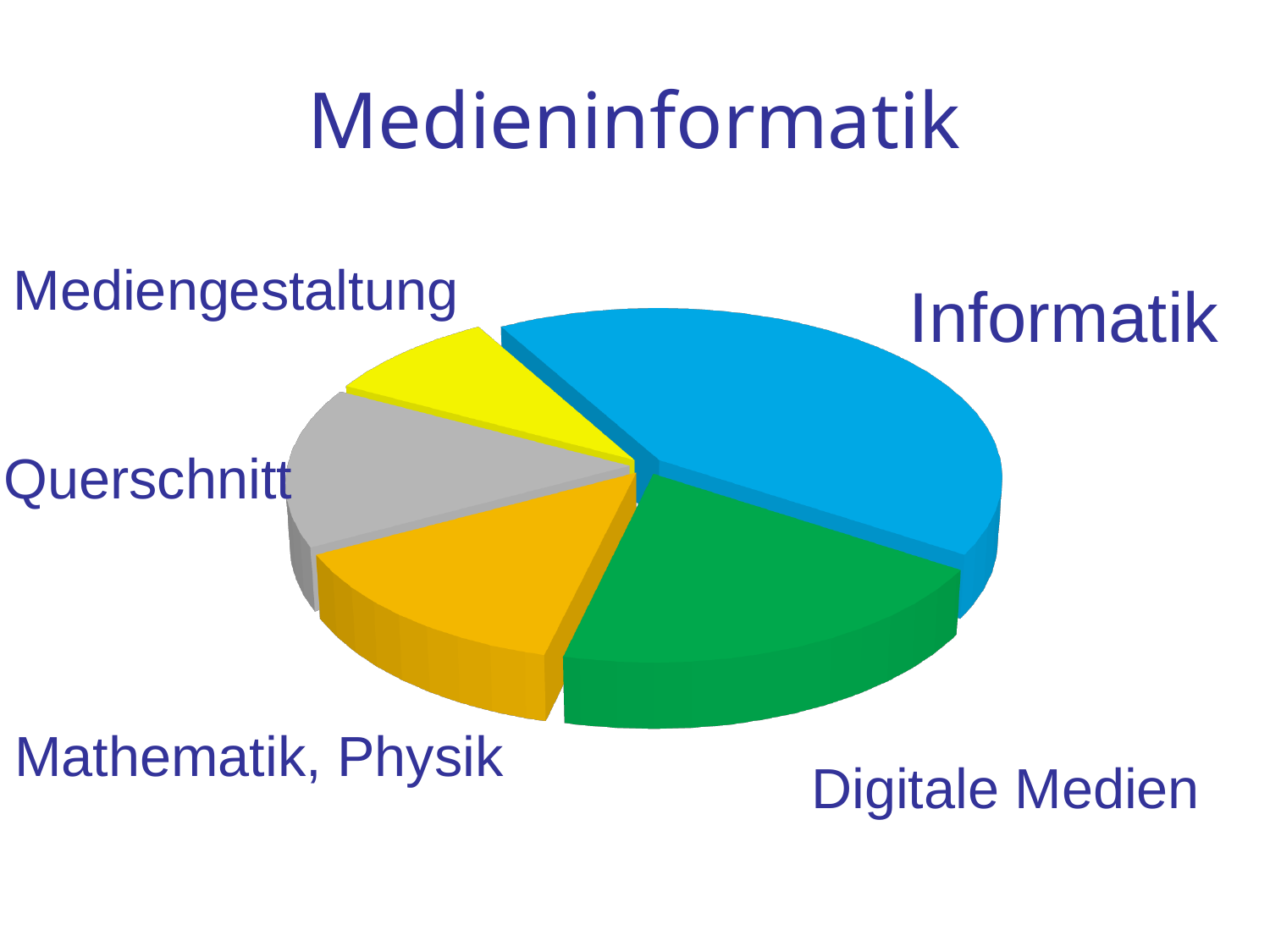
Which slice of the pie chart is the largest? Informatik Which slice is larger, Digitale Medien or Mediengestaltung? Digitale Medien What kind of chart is shown on the slide? pie chart What colour is the Informatik slice of the pie chart? blue Which slice is larger, Mediengestaltung or Informatik? Informatik Which slice of the pie chart is the smallest? Mediengestaltung What is the title of the slide above the pie chart? Medieninformatik Which slice is larger, Informatik or Digitale Medien? Informatik How many slices does the pie chart have? 5